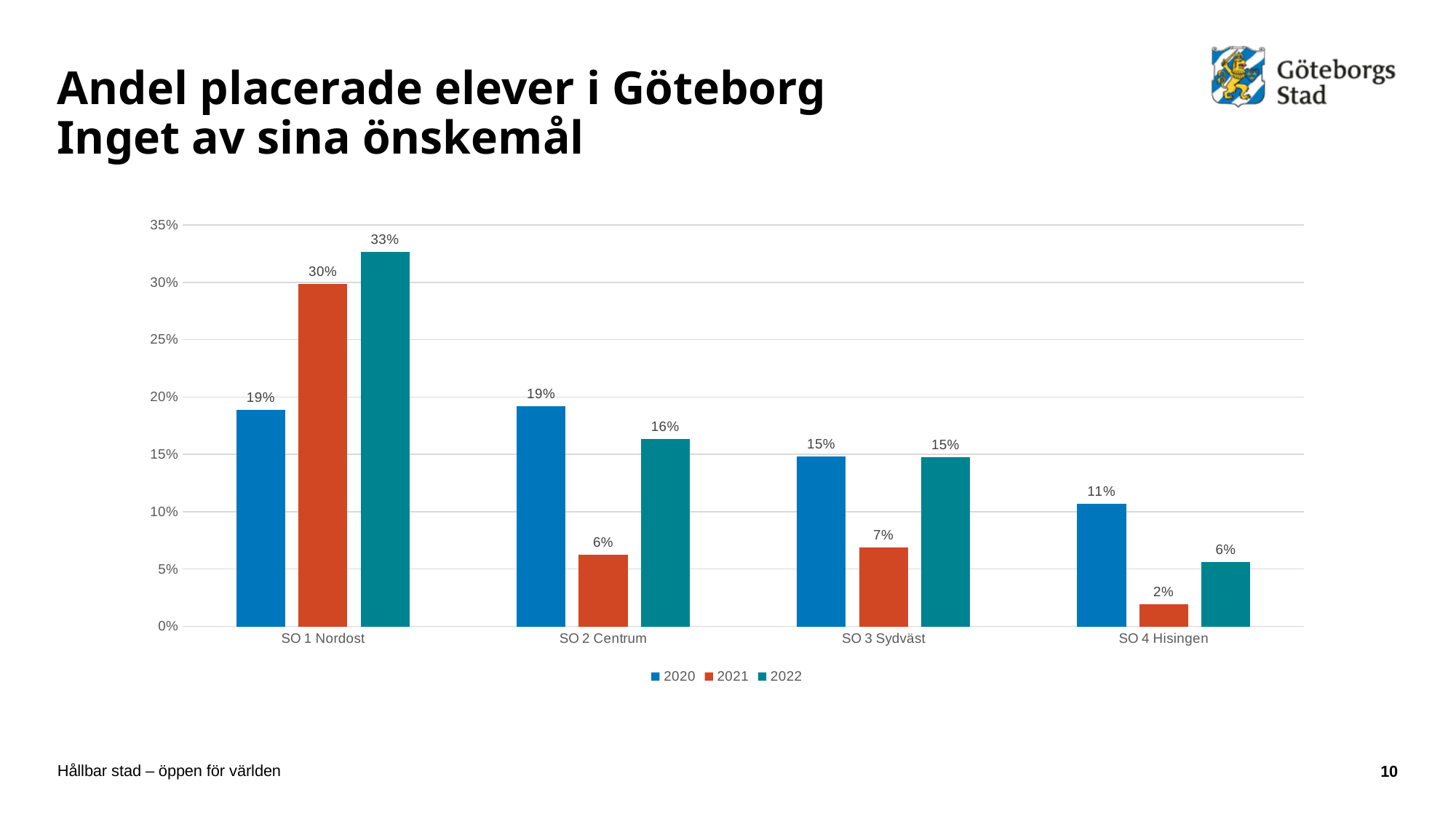
What is the value for SO 1 Nordost in 2022? 33% Which is larger for SO 3 Sydväst: the 2020 value or the 2021 value? 2020 Which years are listed in the legend? 2020, 2021, 2022 What kind of chart is shown on the slide? Bar chart How many series does the legend list? 3 Which category has the lowest value in the 2022 series? SO 4 Hisingen What is the difference between the 2022 and 2020 values for SO 1 Nordost? 14% Is the value for SO 1 Nordost in 2021 greater or less than 25%? greater What is the value for SO 2 Centrum in 2020? 19% Which category has the highest value in the 2021 series? SO 1 Nordost What is the value for SO 4 Hisingen in 2021? 2% How many categories are shown on the x axis? 4